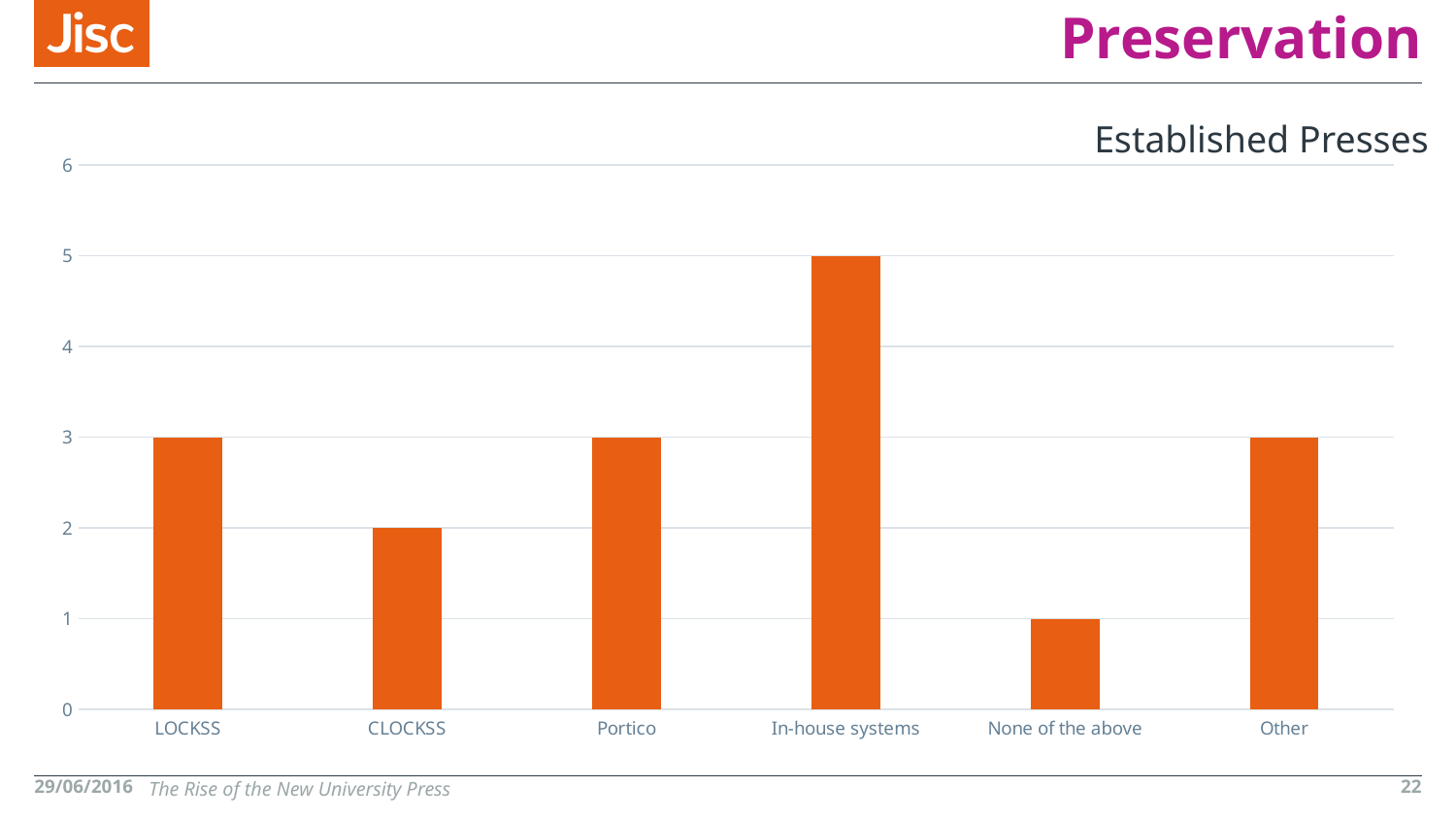
What is the value for In-house systems? 5 What kind of chart is shown on the slide? Bar chart How many categories are shown on the x axis? 6 Is the value for In-house systems greater or less than 4? greater Which category has the highest value? In-house systems Which category has the lowest value? None of the above What is the title of the chart? Established Presses What is the value for Portico? 3 Which is larger, the value for LOCKSS or the value for CLOCKSS? LOCKSS What is the value for CLOCKSS? 2 What is the value for None of the above? 1 What is the difference between the values for In-house systems and CLOCKSS? 3